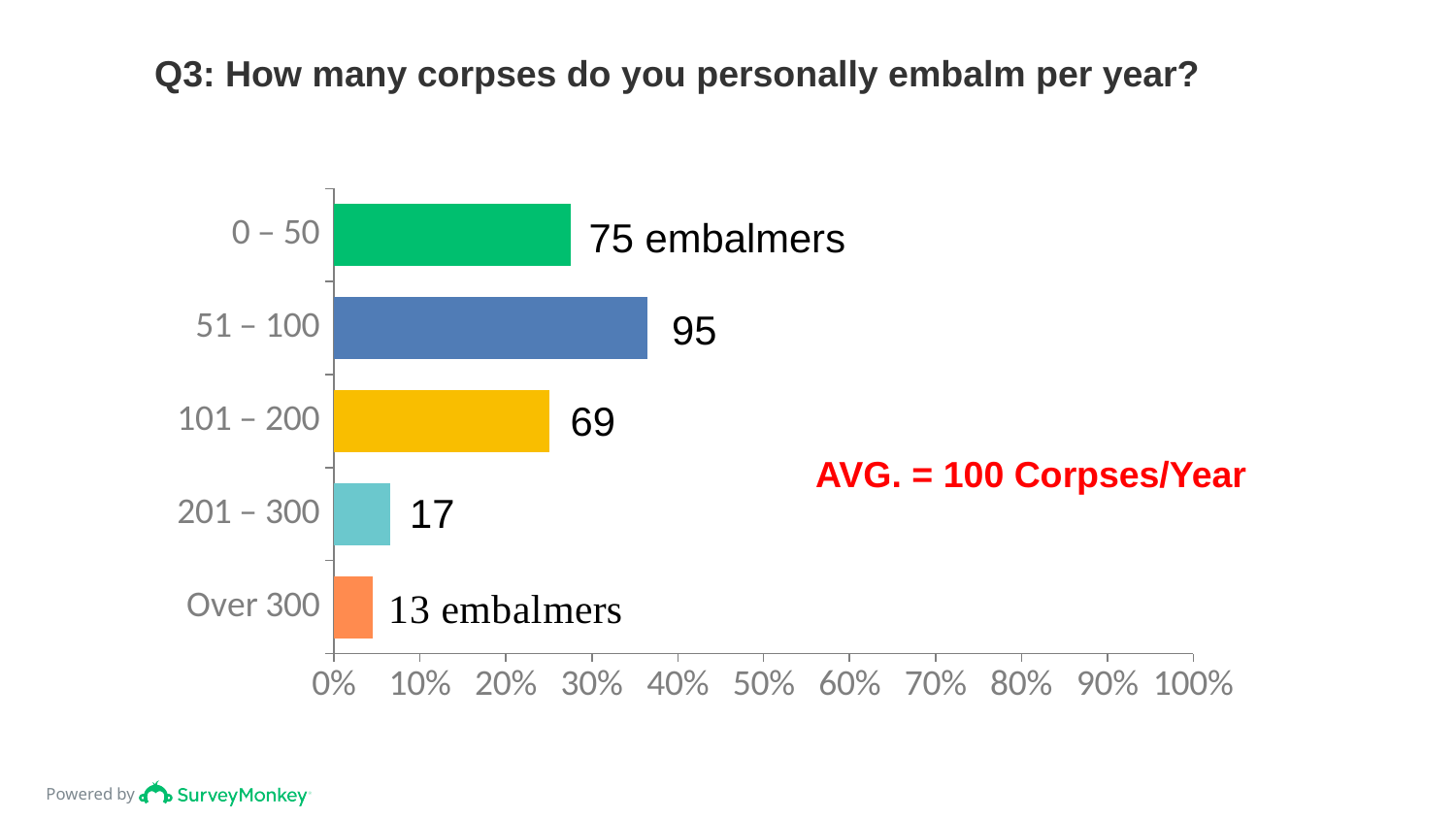
How many embalmers are in the 201 – 300 category? 17 Which category has the lowest number of embalmers? Over 300 How many embalmers are in the 51 – 100 category? 95 How many categories are shown in the chart? 5 Which category has more embalmers, 101 – 200 or 201 – 300? 101 – 200 How many embalmers are in the 0 – 50 category? 75 embalmers Is the value for Over 300 greater or less than 10%? less Which category has the highest number of embalmers? 51 – 100 How many embalmers are in the 101 – 200 category? 69 What average is stated on the slide? AVG. = 100 Corpses/Year How many embalmers are in the Over 300 category? 13 embalmers What is the difference in the number of embalmers between the 51 – 100 and 0 – 50 categories? 20